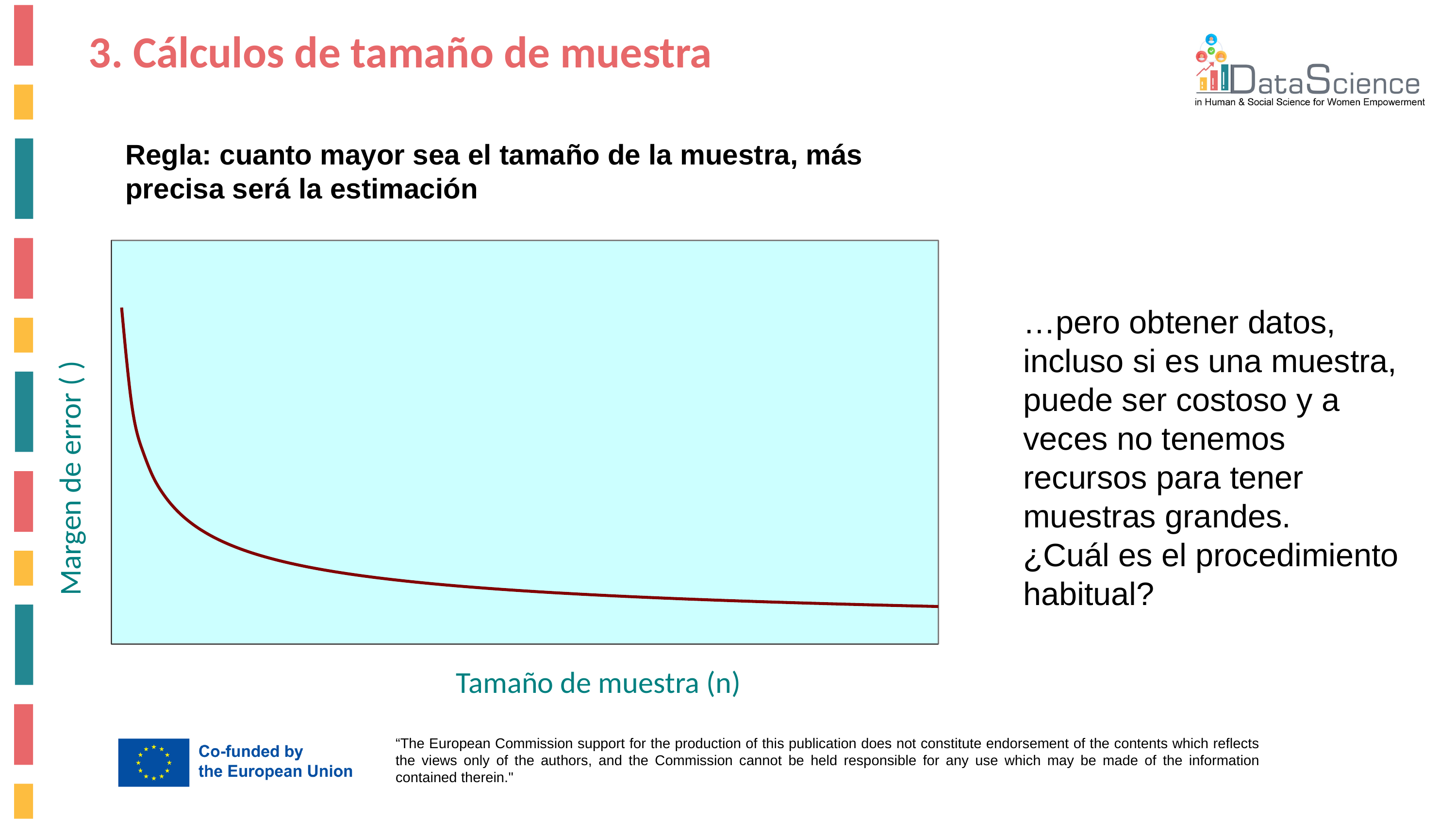
What kind of chart is shown on the slide? line chart What is the label of the x axis of the chart? Tamaño de muestra (n) Does the plotted line rise or fall as the sample size (n) increases along the x axis? fall What is the label of the y axis of the chart? Margen de error ( ) Is the margin of error higher at small sample sizes or at large sample sizes according to the chart? small sample sizes How many lines are plotted on the chart? 1